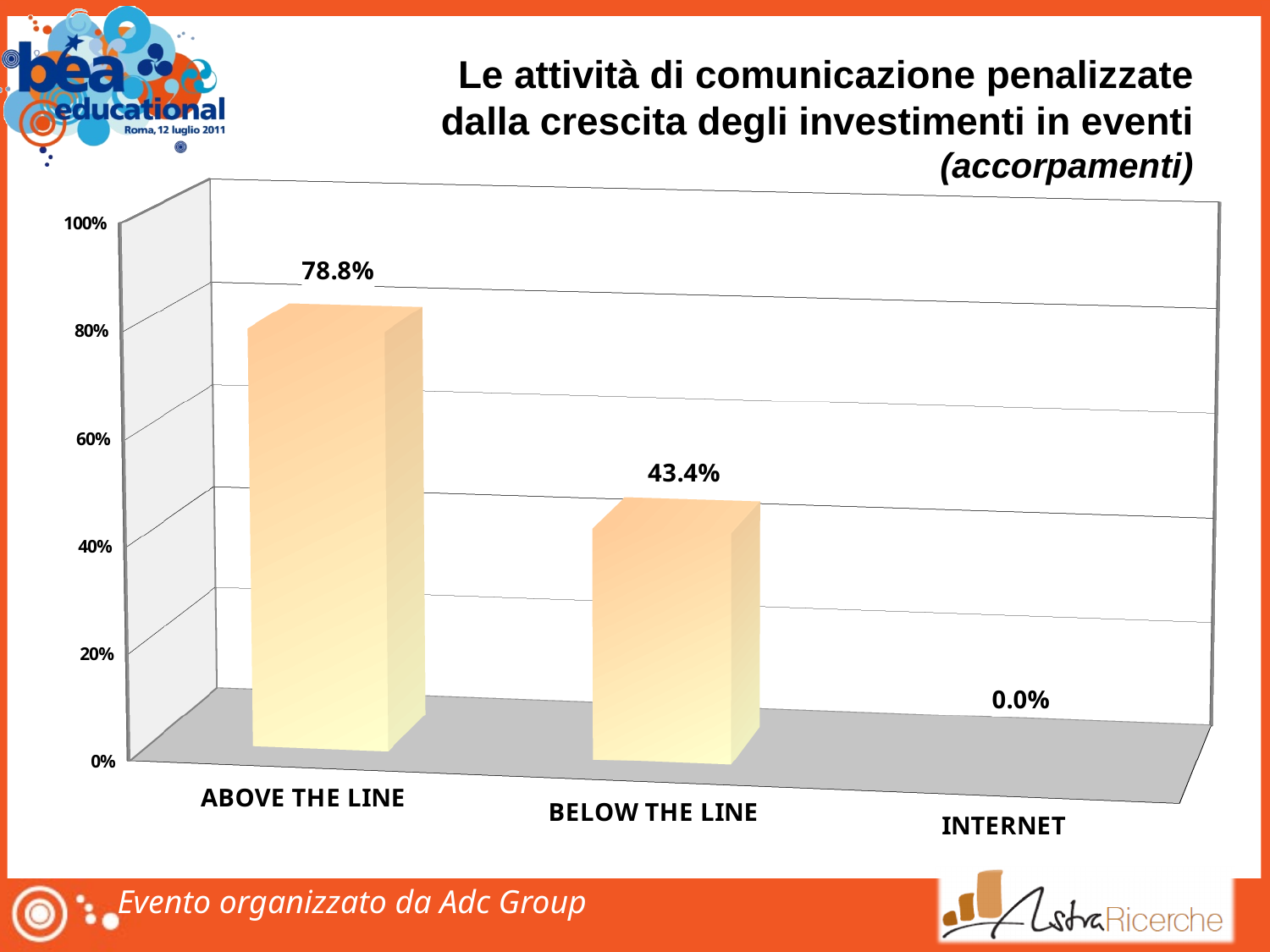
What is the difference between the values for ABOVE THE LINE and BELOW THE LINE? 35.4% What is the value for ABOVE THE LINE? 78.8% What is the value for INTERNET? 0.0% Which category has the lowest value? INTERNET Is the value for BELOW THE LINE greater or less than 60%? less Which is larger, the value for ABOVE THE LINE or the value for BELOW THE LINE? ABOVE THE LINE Do the values rise or fall from left to right across the categories? fall What is the highest value shown on the vertical axis? 100% What is the value for BELOW THE LINE? 43.4% What kind of chart is shown on the slide? bar chart Which category has the highest value? ABOVE THE LINE How many categories are shown on the chart? 3